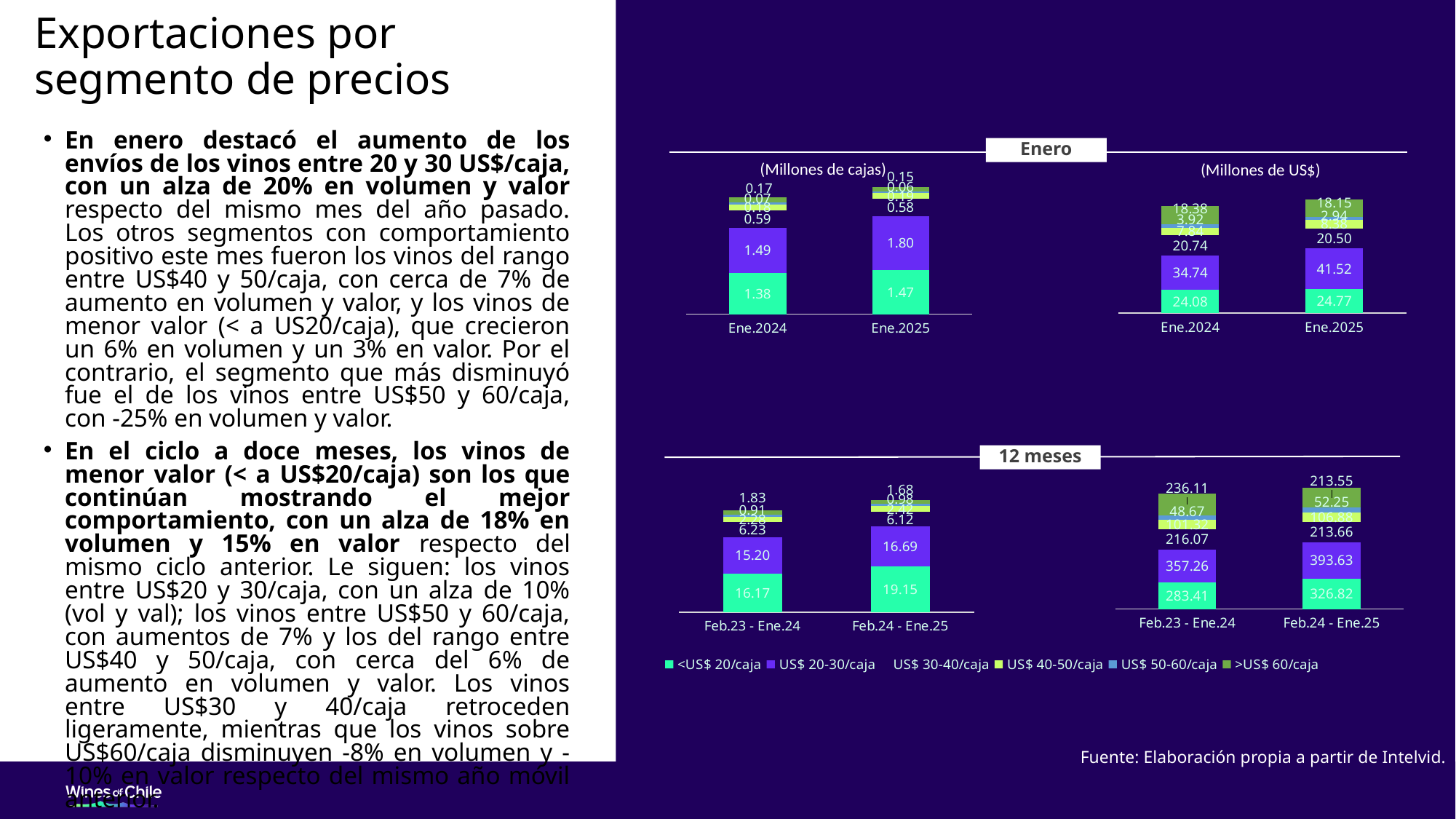
In the 'Enero' chart in millions of US$ (top right), what is the value for the <US$ 20/caja segment in Ene.2024? 24.08 What kind of chart is used in the '12 meses' section in millions of US$ (bottom right)? Stacked bar chart In the '12 meses' chart in millions of US$ (bottom right), what is the value for the US$ 20-30/caja segment in Feb.24 - Ene.25? 393.63 In the '12 meses' chart in millions of cajas (bottom left), which period has the larger US$ 20-30/caja value, Feb.23 - Ene.24 or Feb.24 - Ene.25? Feb.24 - Ene.25 In the 'Enero' chart in millions of cajas (top left), what is the value for the US$ 20-30/caja segment in Ene.2024? 1.49 In the 'Enero' chart in millions of cajas (top left), what is the value for the <US$ 20/caja segment in Ene.2025? 1.47 How many series does the legend list? 6 In the 'Enero' chart in millions of US$ (top right), what is the value for the US$ 20-30/caja segment in Ene.2025? 41.52 In the '12 meses' chart in millions of US$ (bottom right), what is the value for the >US$ 60/caja segment in Feb.23 - Ene.24? 236.11 In the '12 meses' chart in millions of cajas (bottom left), what is the value for the <US$ 20/caja segment in Feb.24 - Ene.25? 19.15 In the 'Enero' chart in millions of US$ (top right), which segment has the highest value in Ene.2025? US$ 20-30/caja In the '12 meses' chart in millions of US$ (bottom right), what is the difference between the <US$ 20/caja values for Feb.24 - Ene.25 and Feb.23 - Ene.24? 43.41